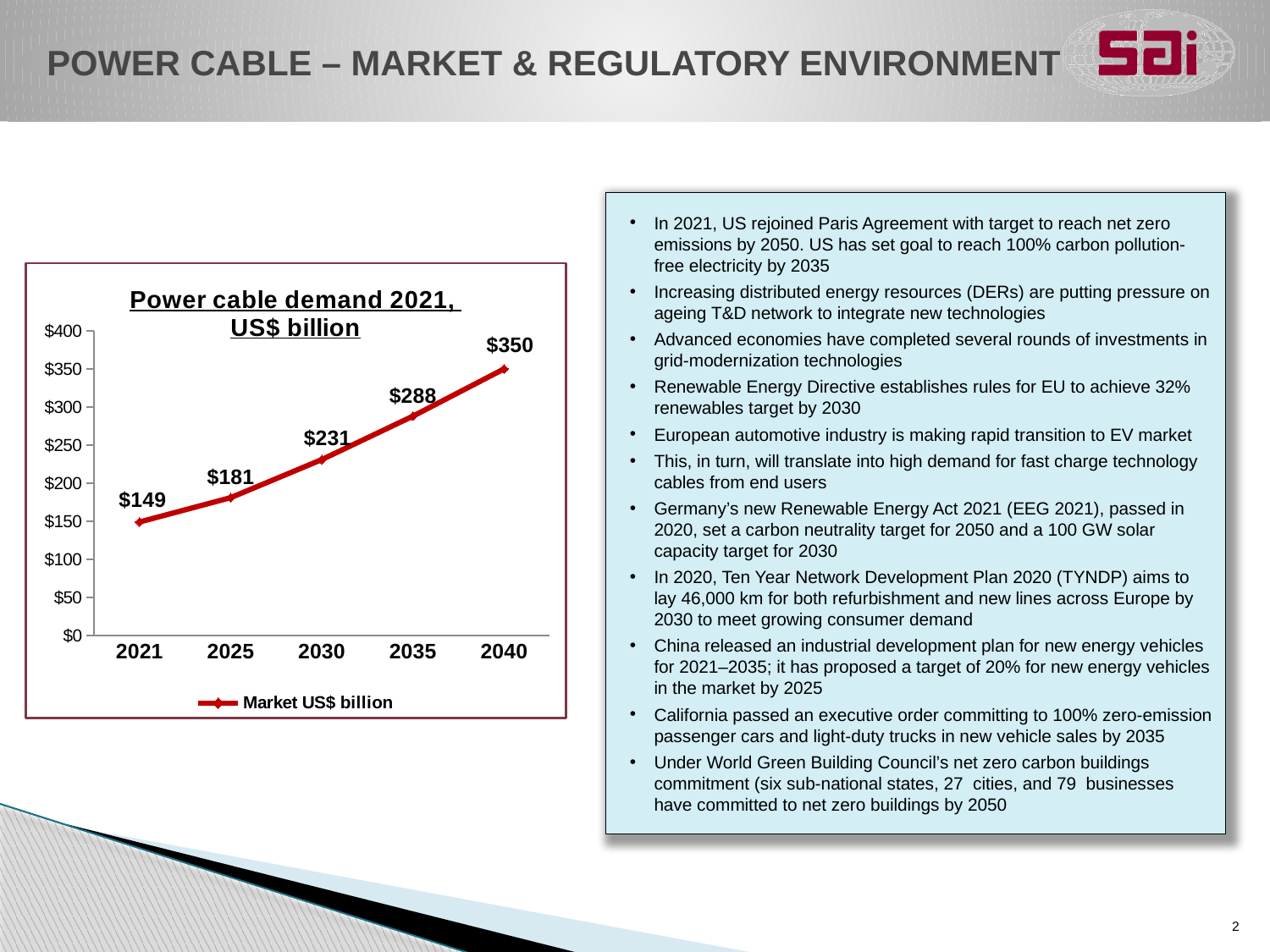
Do the values rise or fall from 2021 to 2040? rise Which year has the lowest market value? 2021 How many series does the legend list? 1 What is the market value for 2030? $231 Is the value for 2035 greater or less than $250? greater How many years are plotted on the chart? 5 What is the market value for 2021? $149 What is the market value for 2040? $350 What kind of chart is shown? line chart Which is larger, the market value for 2030 or for 2025? 2030 Which year has the highest market value? 2040 What is the difference between the market values for 2035 and 2025? $107